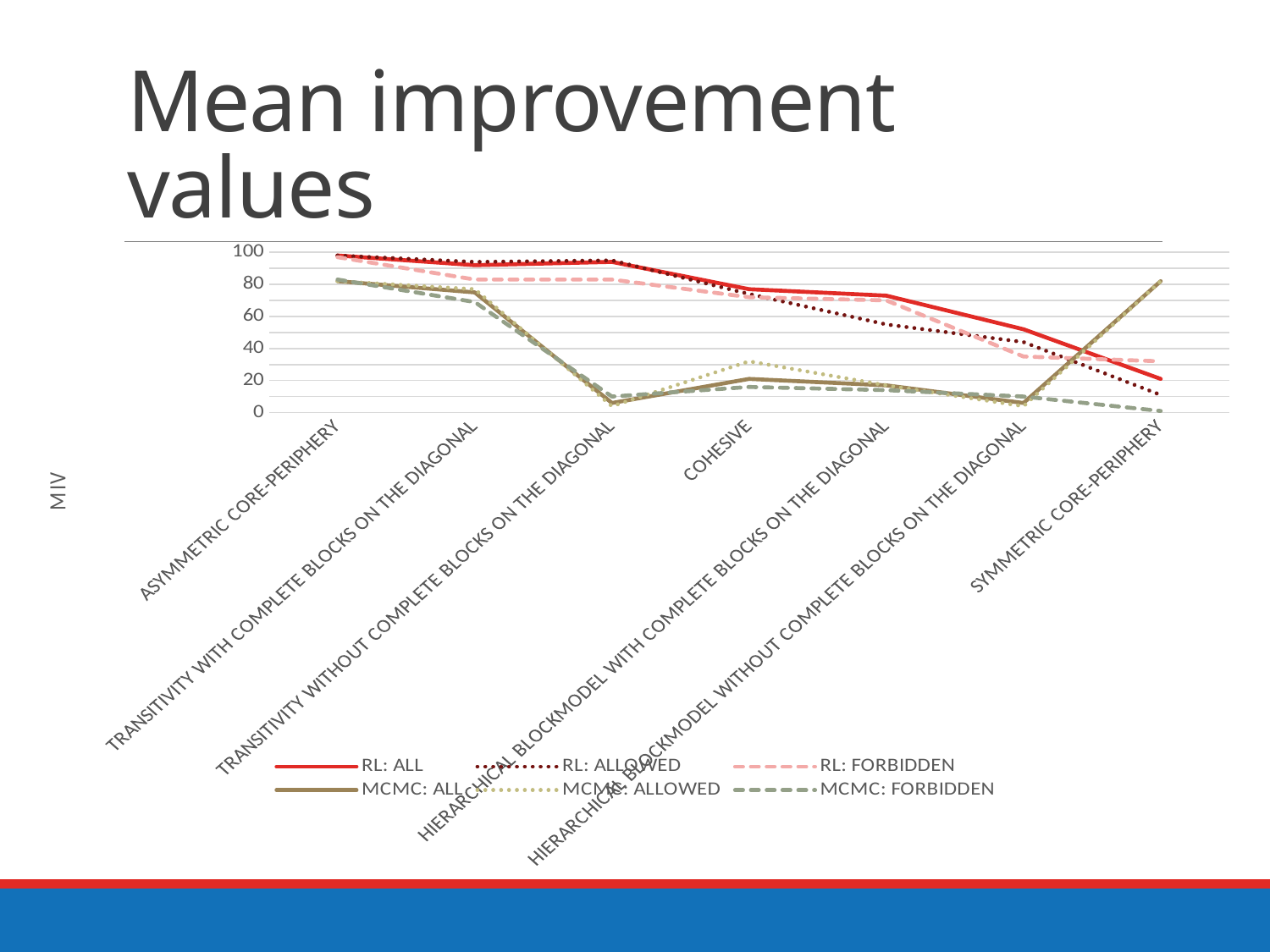
How many categories are shown along the x axis of the chart? 7 For SYMMETRIC CORE-PERIPHERY, which series has the larger value: RL: ALL or MCMC: ALL? MCMC: ALL How many series does the chart's legend list? 6 Is the value of MCMC: ALL for TRANSITIVITY WITHOUT COMPLETE BLOCKS ON THE DIAGONAL greater or less than 20? less What kind of chart is shown on the slide? line chart Is the value of MCMC: ALL for SYMMETRIC CORE-PERIPHERY greater or less than 60? greater Is the value of RL: ALL for ASYMMETRIC CORE-PERIPHERY greater or less than 80? greater Do the values of the RL: ALL series rise or fall from left to right along the x axis? fall For COHESIVE, which series has the larger value: RL: ALL or MCMC: ALL? RL: ALL What is the label on the vertical axis of the chart? MIV For which category is the RL: ALL series at its highest? ASYMMETRIC CORE-PERIPHERY